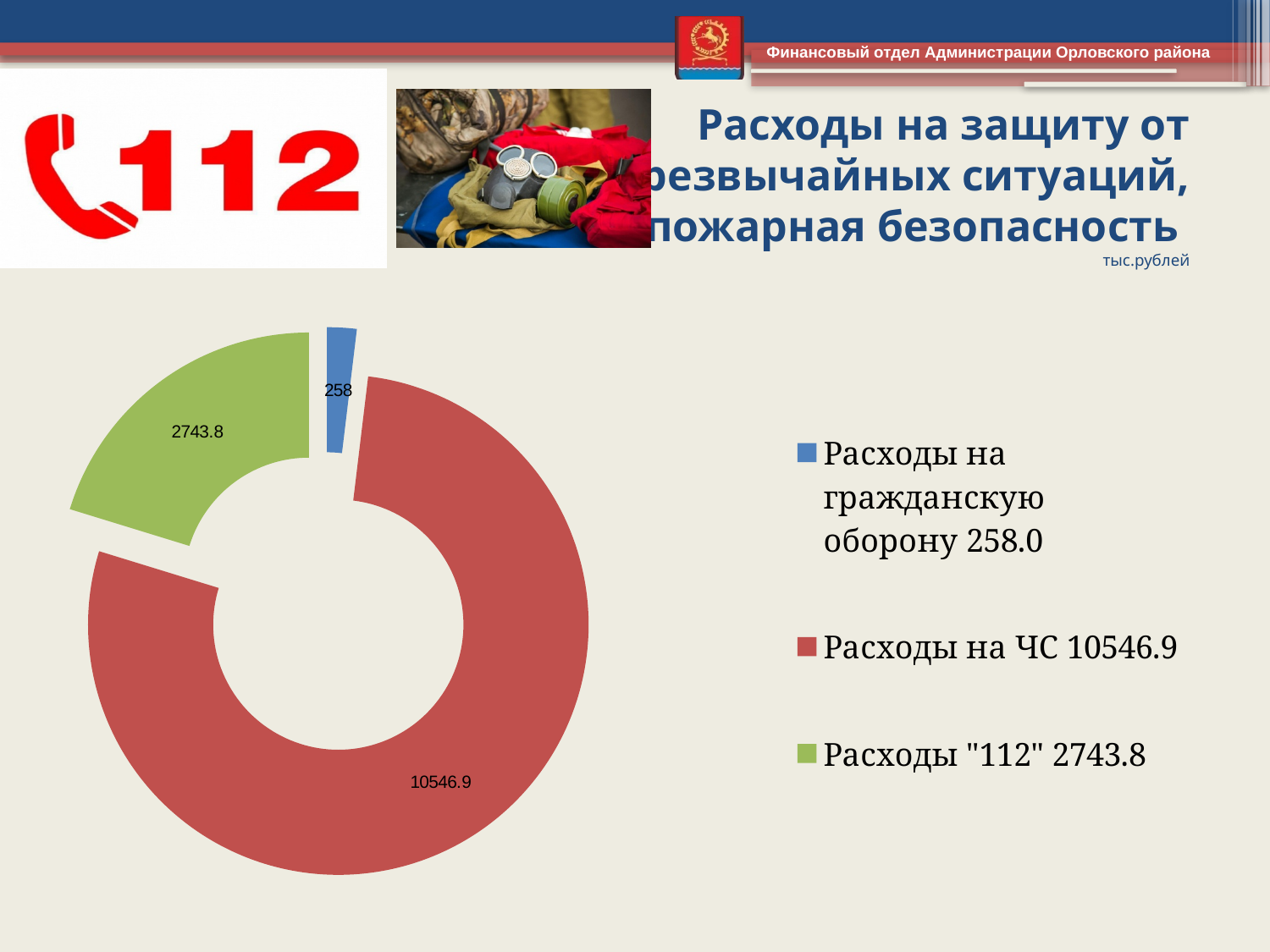
What is the total of all three slices in the chart? 13548.7 What unit is stated for the values in the chart? тыс.рублей Which is larger, Расходы "112" or Расходы на гражданскую оборону? Расходы "112" Which category has the smallest slice in the chart? Расходы на гражданскую оборону What is the difference between Расходы на ЧС and Расходы "112"? 7803.1 What is the difference between Расходы "112" and Расходы на гражданскую оборону? 2485.8 What type of chart is shown on the slide? doughnut chart What is the value for Расходы "112" in the chart? 2743.8 Which category has the largest slice in the chart? Расходы на ЧС How many categories does the chart show? 3 What is the value for Расходы на гражданскую оборону in the chart? 258 What is the value for Расходы на ЧС in the chart? 10546.9